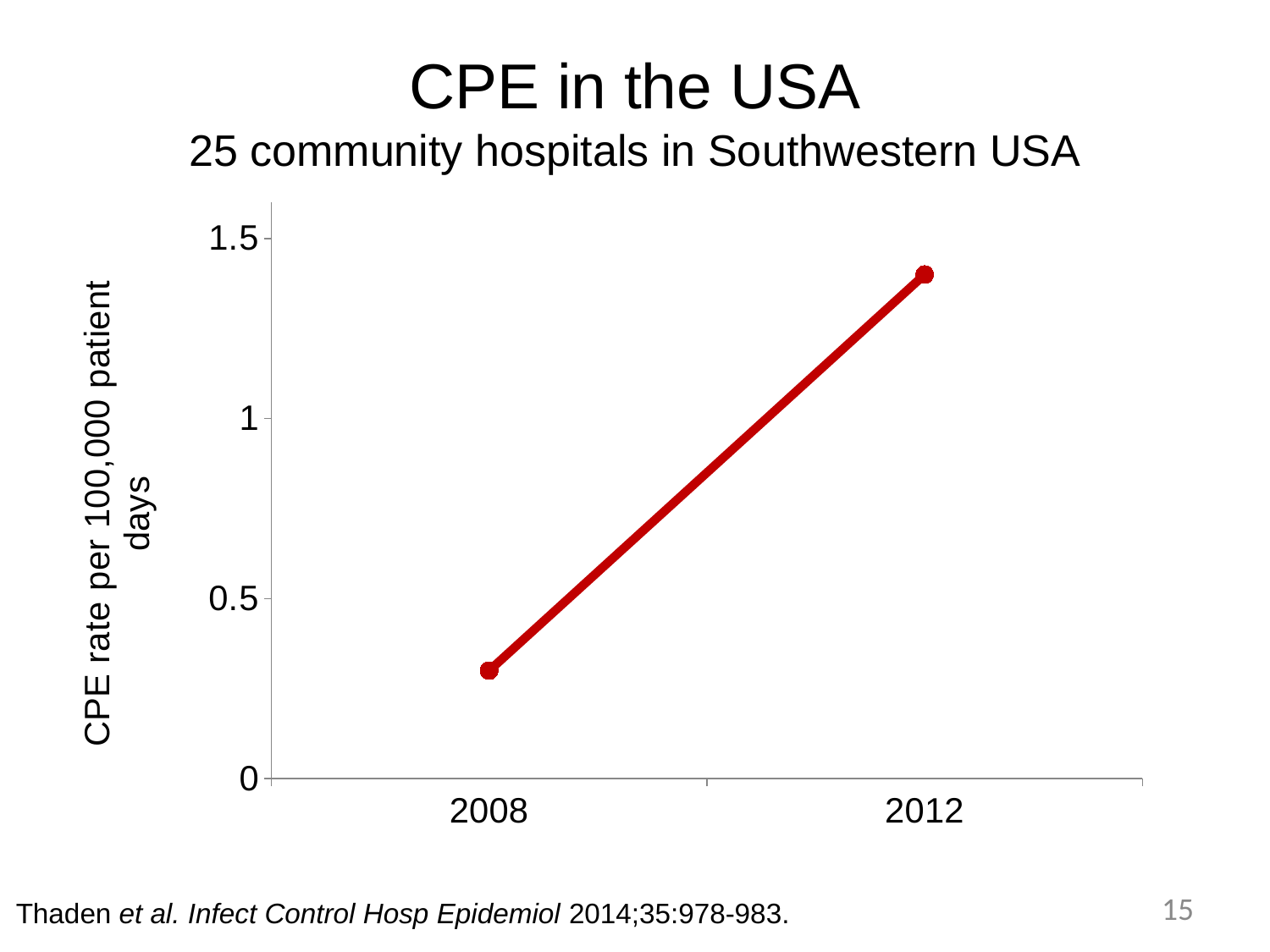
What is the title of the chart on the slide? CPE in the USA Is the CPE rate for 2008 greater or less than 0.5? less Is the CPE rate for 2012 greater or less than 1? greater Which year has the highest CPE rate on the chart? 2012 Is the CPE rate for 2012 greater or less than 1.5? less What kind of chart is shown on the slide? line chart Which year has the higher CPE rate, 2008 or 2012? 2012 Which year has the lowest CPE rate on the chart? 2008 How many data points are plotted on the chart? 2 What is the label on the y axis of the chart? CPE rate per 100,000 patient days Does the CPE rate rise or fall from 2008 to 2012? rise